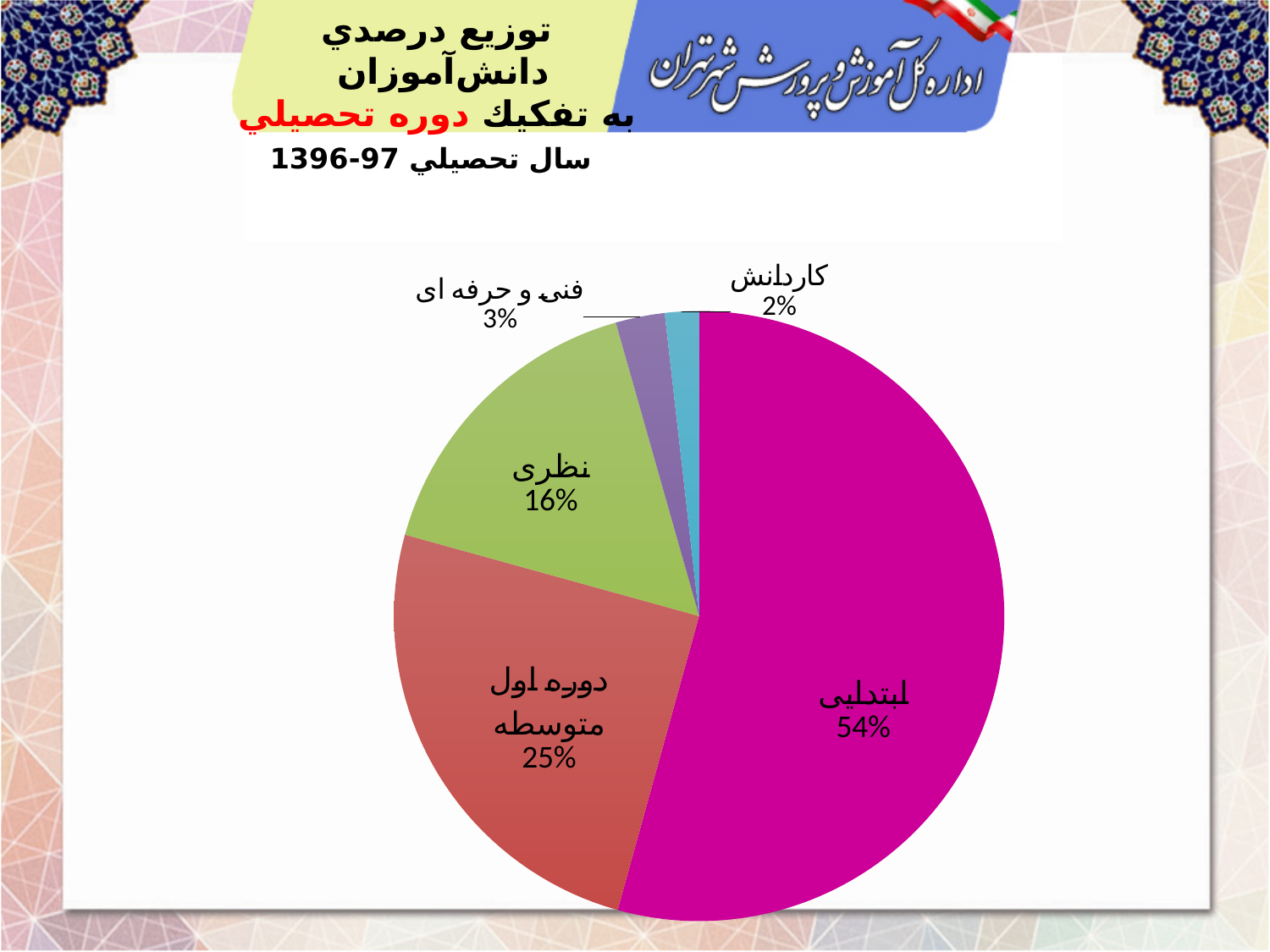
How many slices does the pie chart have? 5 Which is larger, the share for نظری or the share for فنی و حرفه ای? نظری Which category has the smallest share of the pie? کاردانش What is the difference in percentage points between ابتدایی and دوره اول متوسطه? 29 What percentage is shown for کاردانش? 2% What kind of chart is shown on the slide? pie chart What percentage of the pie is the ابتدایی slice? 54% What percentage is shown for نظری? 16% What percentage is shown for فنی و حرفه ای? 3% What percentage is shown for دوره اول متوسطه? 25% Which academic year does the chart title refer to? 1396-97 Which category has the largest share of the pie? ابتدایی